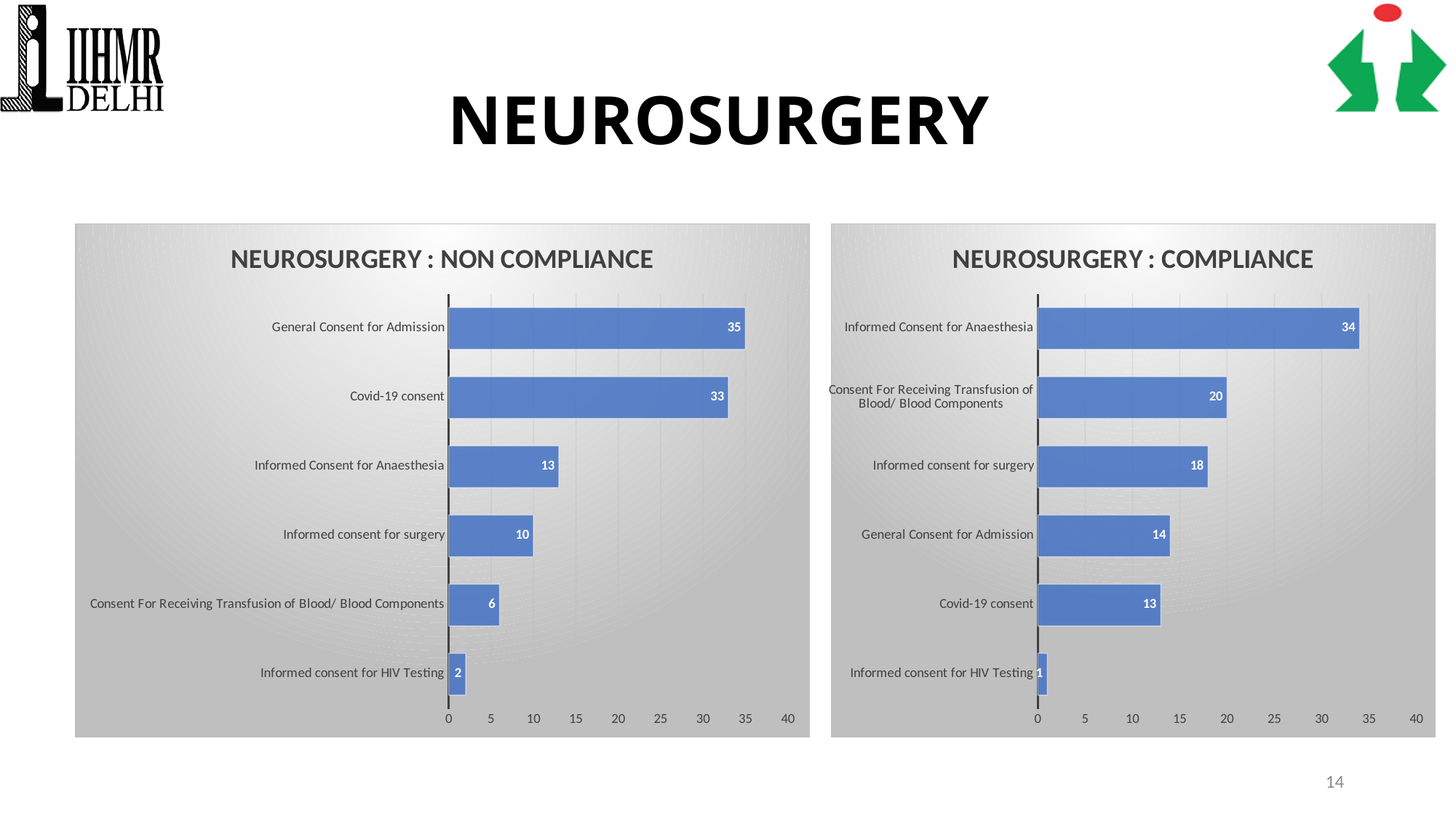
How many categories are shown in the NEUROSURGERY : COMPLIANCE chart? 6 In the NEUROSURGERY : COMPLIANCE chart, which is larger: Consent For Receiving Transfusion of Blood/ Blood Components or General Consent for Admission? Consent For Receiving Transfusion of Blood/ Blood Components In the NEUROSURGERY : NON COMPLIANCE chart, what is the value for Consent For Receiving Transfusion of Blood/ Blood Components? 6 In the NEUROSURGERY : COMPLIANCE chart, what is the value for Informed consent for surgery? 18 In the NEUROSURGERY : NON COMPLIANCE chart, what is the value for Covid-19 consent? 33 In the NEUROSURGERY : COMPLIANCE chart, what is the difference between Informed Consent for Anaesthesia and Covid-19 consent? 21 What kind of chart is the NEUROSURGERY : NON COMPLIANCE chart? Bar chart In the NEUROSURGERY : NON COMPLIANCE chart, which category has the highest value? General Consent for Admission In the NEUROSURGERY : NON COMPLIANCE chart, is the value for Informed consent for surgery greater or less than 15? less In the NEUROSURGERY : NON COMPLIANCE chart, what is the difference between General Consent for Admission and Informed Consent for Anaesthesia? 22 What is the title of the chart on the right side of the slide? NEUROSURGERY : COMPLIANCE In the NEUROSURGERY : COMPLIANCE chart, which category has the lowest value? Informed consent for HIV Testing